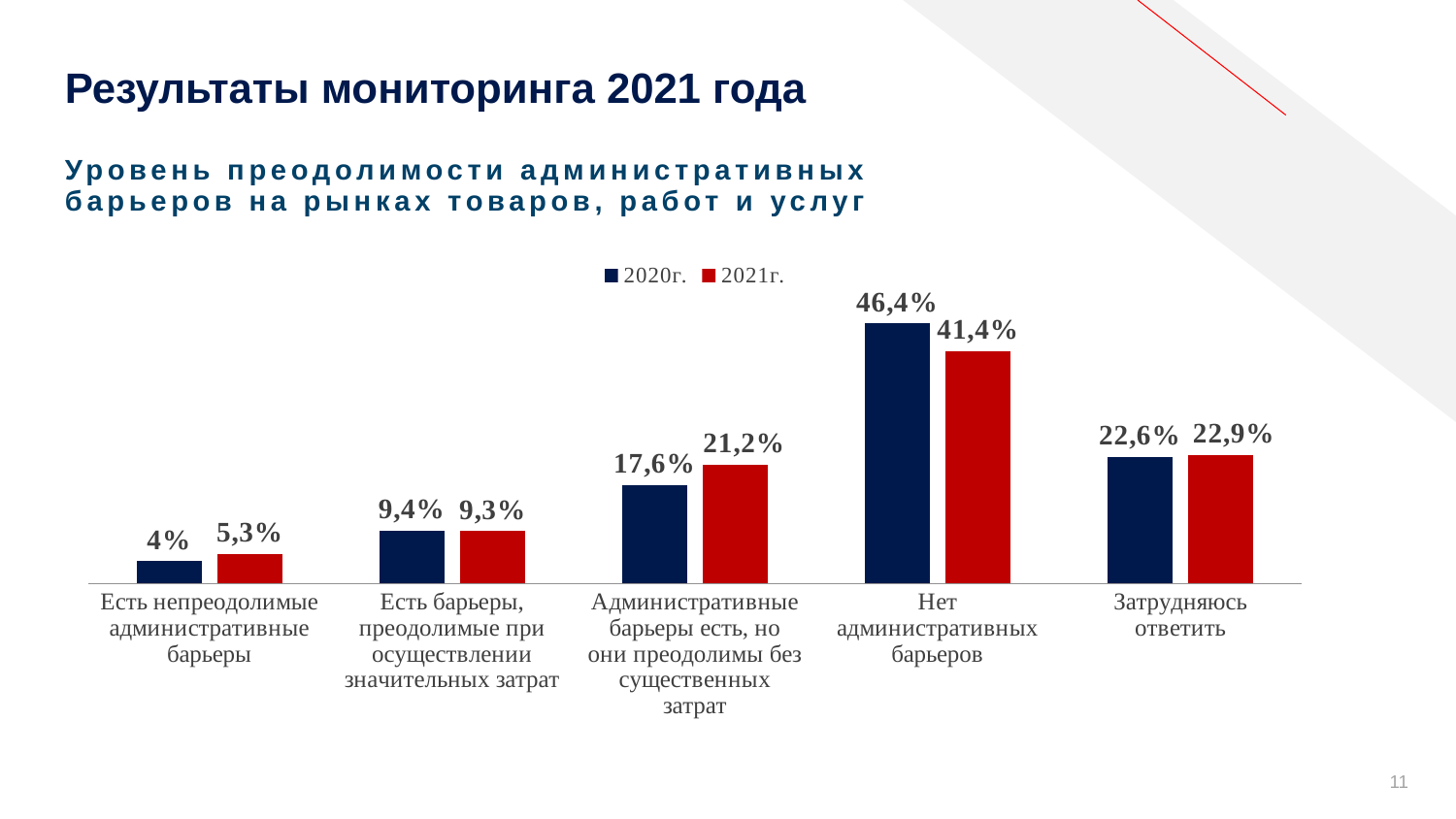
What type of chart is shown on the slide? Bar chart What is the difference between the 2021г. and 2020г. values for «Административные барьеры есть, но они преодолимы без существенных затрат»? 3,6 percentage points How many series does the legend list? 2 What is the 2021г. value for «Нет административных барьеров»? 41,4% What is the 2021г. value for «Административные барьеры есть, но они преодолимы без существенных затрат»? 21,2% How many categories are shown on the x axis? 5 Which colour represents the 2021г. series in the legend? Red Which category has the lowest 2021г. value? Есть непреодолимые административные барьеры Which category has the highest 2020г. value? Нет административных барьеров For «Есть непреодолимые административные барьеры», which year has the larger value, 2020г. or 2021г.? 2021г. What is the difference between the 2020г. and 2021г. values for «Нет административных барьеров»? 5 percentage points What is the 2020г. value for «Есть непреодолимые административные барьеры»? 4%